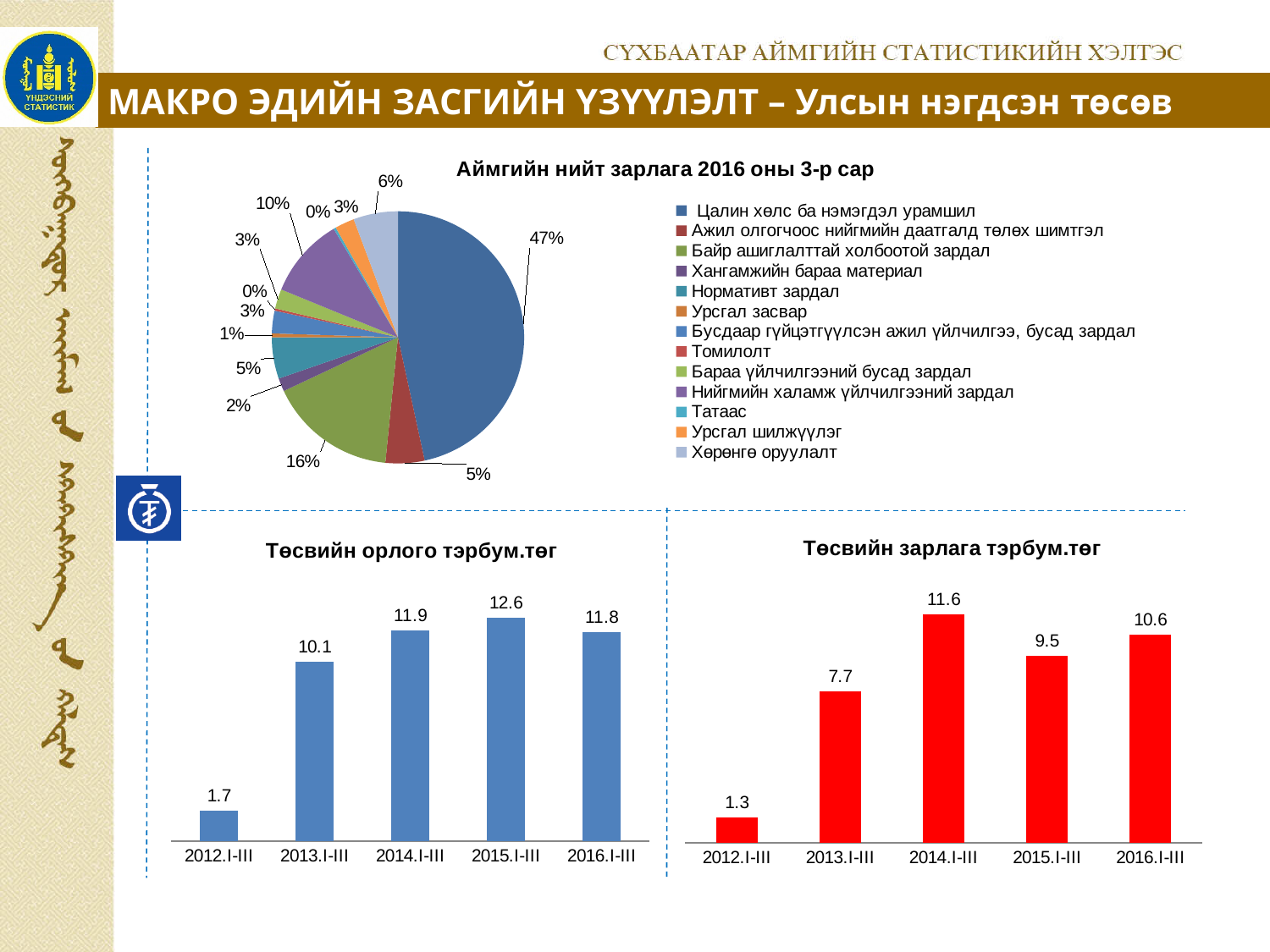
In the chart titled 'Төсвийн зарлага тэрбум.төг', what is the value for 2013.I-III? 7.7 In the chart titled 'Төсвийн орлого тэрбум.төг', which period has the highest value? 2015.I-III In the chart titled 'Төсвийн зарлага тэрбум.төг', what is the difference between the values for 2014.I-III and 2015.I-III? 2.1 What kind of chart is the one titled 'Аймгийн нийт зарлага 2016 оны 3-р сар'? pie chart In the chart titled 'Төсвийн зарлага тэрбум.төг', which is larger: the value for 2015.I-III or 2016.I-III? 2016.I-III In the chart titled 'Төсвийн орлого тэрбум.төг', what is the value for 2015.I-III? 12.6 How many entries does the legend of the pie chart titled 'Аймгийн нийт зарлага 2016 оны 3-р сар' list? 13 How many periods are shown on the x axis of the chart titled 'Төсвийн орлого тэрбум.төг'? 5 In the pie chart titled 'Аймгийн нийт зарлага 2016 оны 3-р сар', what share does the largest slice have? 47% In the chart titled 'Төсвийн орлого тэрбум.төг', what is the difference between the values for 2015.I-III and 2016.I-III? 0.8 In the chart titled 'Төсвийн зарлага тэрбум.төг', which period has the highest value? 2014.I-III In the chart titled 'Төсвийн зарлага тэрбум.төг', which period has the lowest value? 2012.I-III